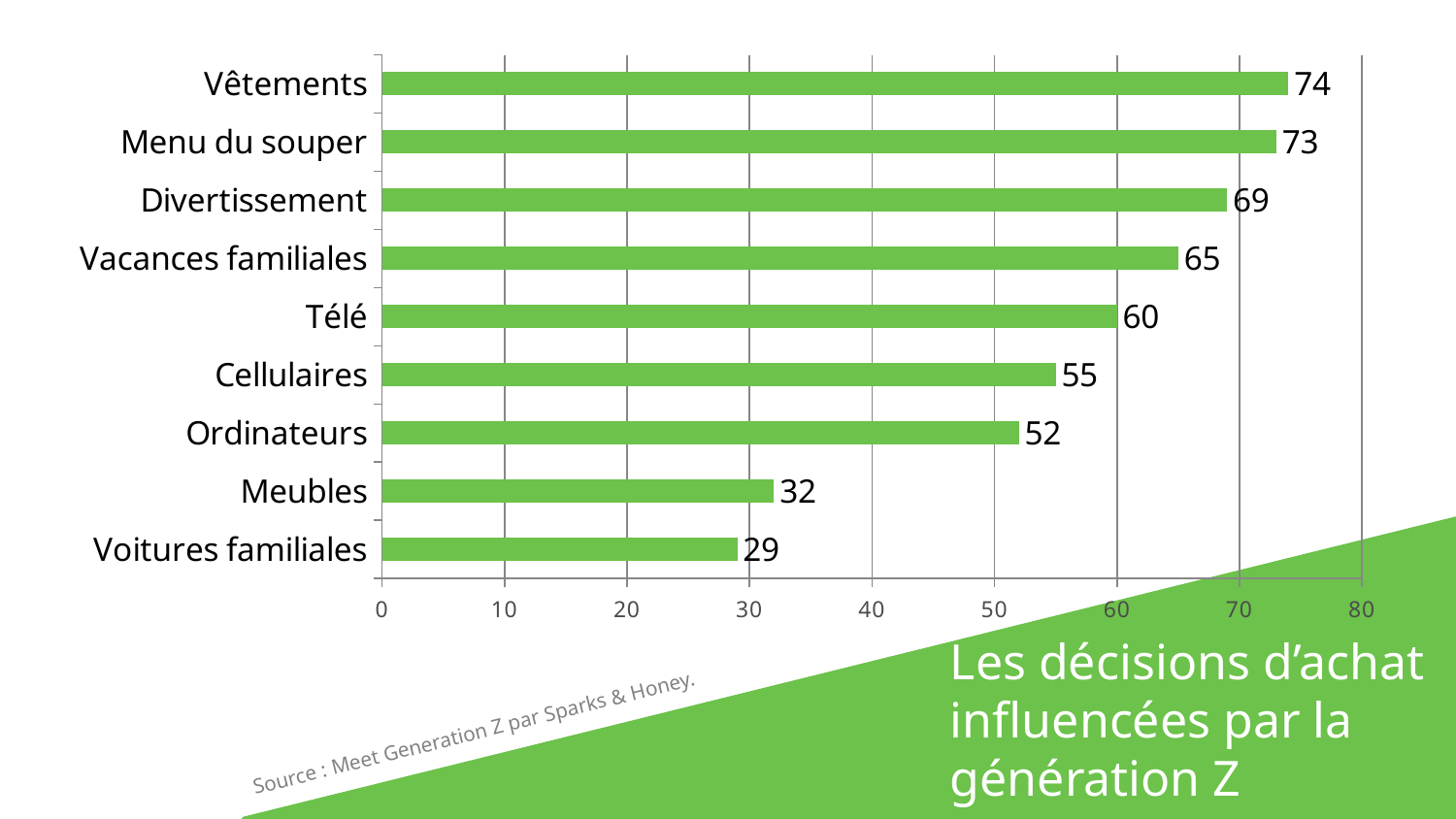
Which category has the highest value? Vêtements Which category has the lowest value? Voitures familiales Which is larger, the value for Cellulaires or the value for Vacances familiales? Vacances familiales How many categories are shown in the chart? 9 Is the value for Menu du souper greater or less than 70? greater What is the value for Télé? 60 What is the value for Vêtements? 74 What is the difference between the values for Meubles and Voitures familiales? 3 What colour are the bars in the chart? green What is the value for Meubles? 32 What is the difference between the values for Divertissement and Ordinateurs? 17 What kind of chart is shown on the slide? bar chart